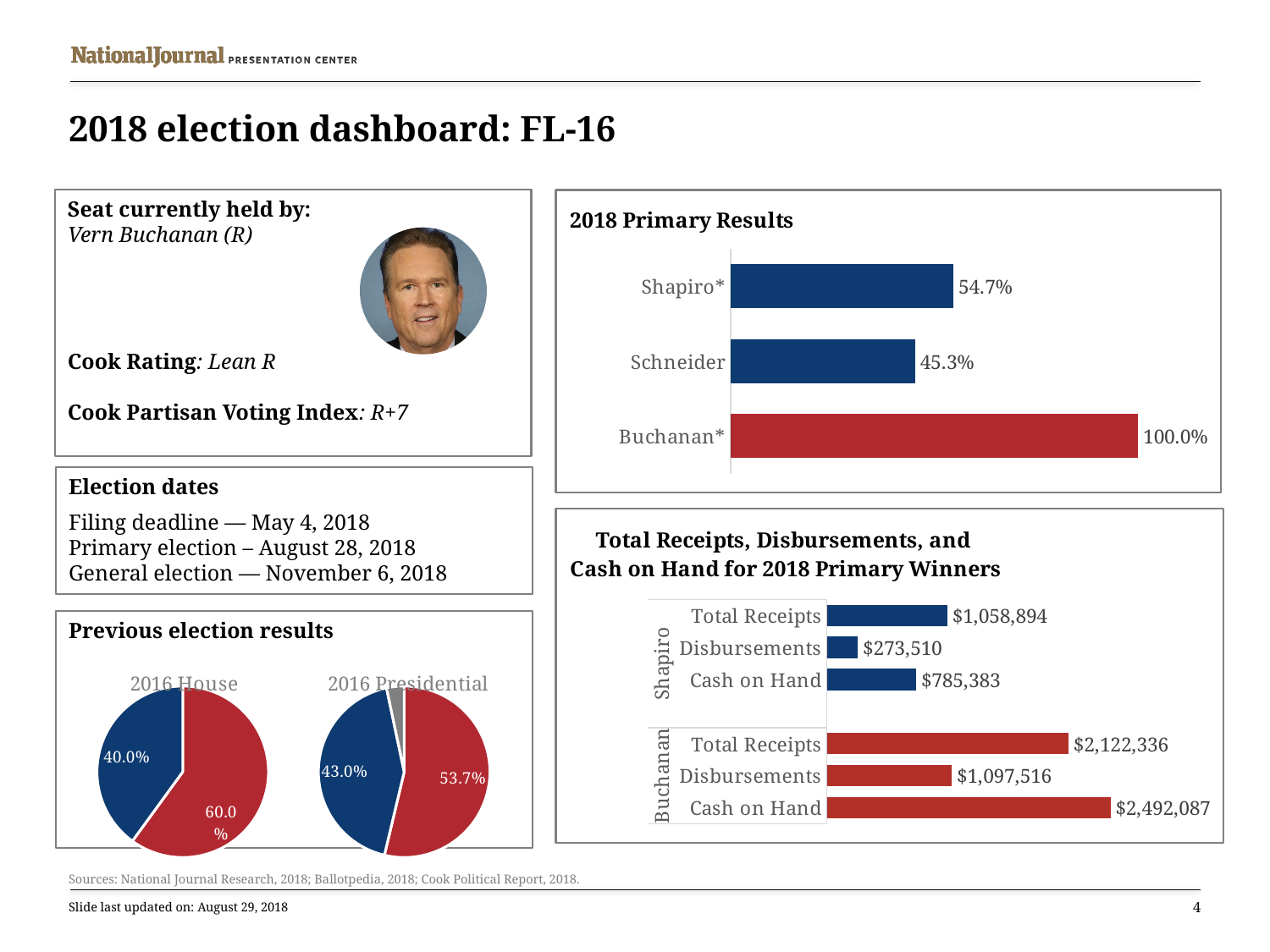
In the Total Receipts, Disbursements, and Cash on Hand chart, what is the difference between Buchanan's and Shapiro's Total Receipts? $1,063,442 In the Total Receipts, Disbursements, and Cash on Hand chart, what are Buchanan's Disbursements? $1,097,516 What kind of chart is the 2018 Primary Results chart? Bar chart In the 2016 House pie chart, what share does the red slice represent? 60.0% In the 2018 Primary Results chart, which candidate has the highest value? Buchanan* In the Total Receipts, Disbursements, and Cash on Hand chart, what is Shapiro's Cash on Hand? $785,383 In the 2016 Presidential pie chart, what percentage is shown for the blue slice? 43.0% In the 2018 Primary Results chart, what percentage did Schneider receive? 45.3% In the 2018 Primary Results chart, what percentage did Shapiro* receive? 54.7% How many candidates are shown in the 2018 Primary Results chart? 3 In the 2018 Primary Results chart, what is the difference in percentage points between Shapiro* and Schneider? 9.4 In the Total Receipts, Disbursements, and Cash on Hand chart, which candidate has the larger Total Receipts? Buchanan